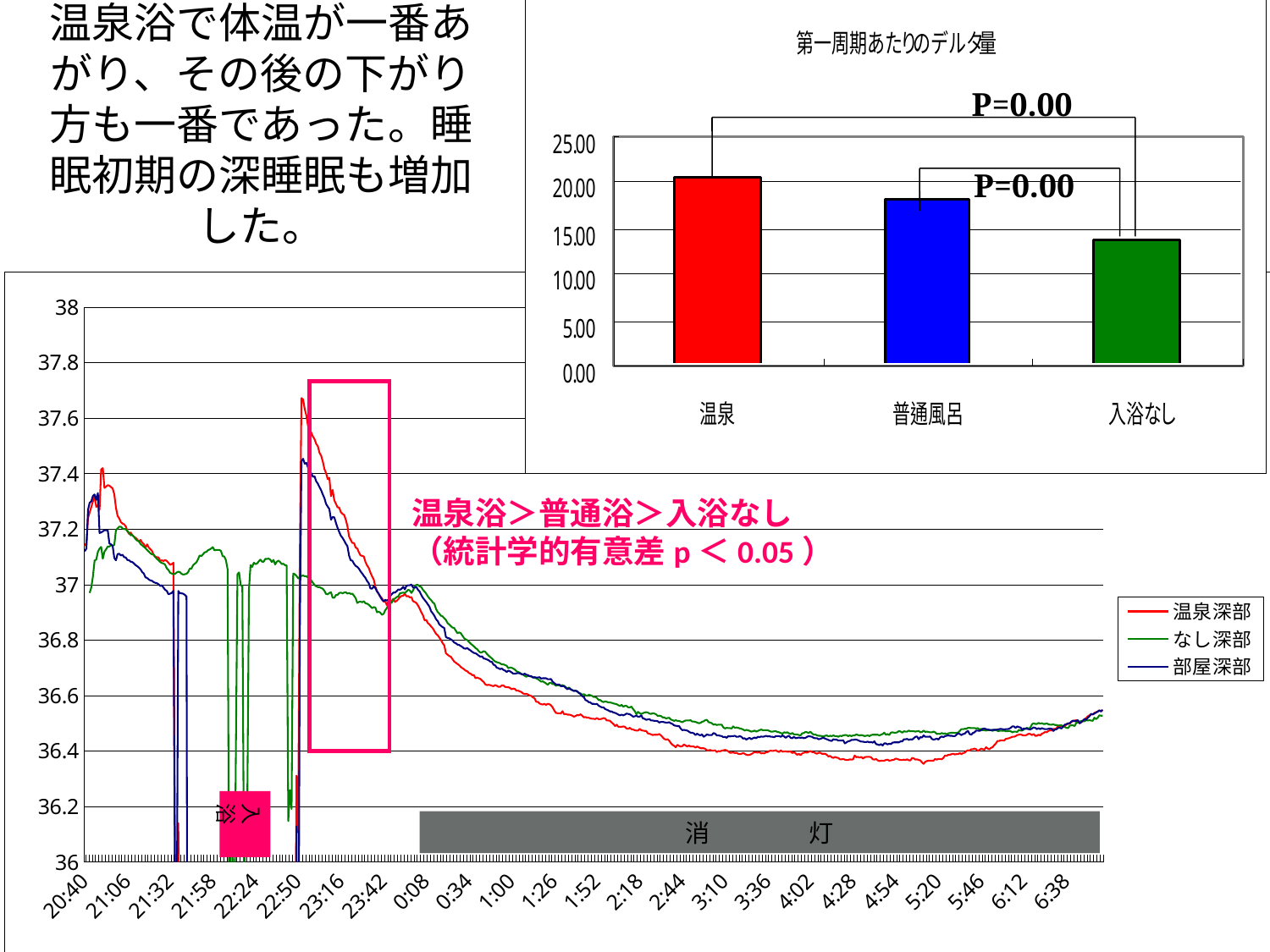
In the bar chart titled 第一周期あたりのデルタ量, is the value for 普通風呂 greater or less than 20.00? less How many series does the legend of the bottom line chart list? 3 In the bottom line chart, which series reaches the highest peak shortly after 22:50? 温泉深部 In the bar chart titled 第一周期あたりのデルタ量, which category has the highest bar? 温泉 What kind of chart is the large chart at the bottom of the slide with times on the x axis? line chart In the bar chart titled 第一周期あたりのデルタ量, which is larger, the bar for 温泉 or the bar for 普通風呂? 温泉 In the bar chart titled 第一周期あたりのデルタ量, is the value for 普通風呂 greater or less than 15.00? greater What kind of chart is the chart titled 第一周期あたりのデルタ量? bar chart How many bars are shown in the bar chart titled 第一周期あたりのデルタ量? 3 In the bottom line chart, do the temperature values rise or fall between 23:42 and 3:10? fall In the bar chart titled 第一周期あたりのデルタ量, is the value for 入浴なし greater or less than 15.00? less In the bar chart titled 第一周期あたりのデルタ量, which category has the lowest bar? 入浴なし